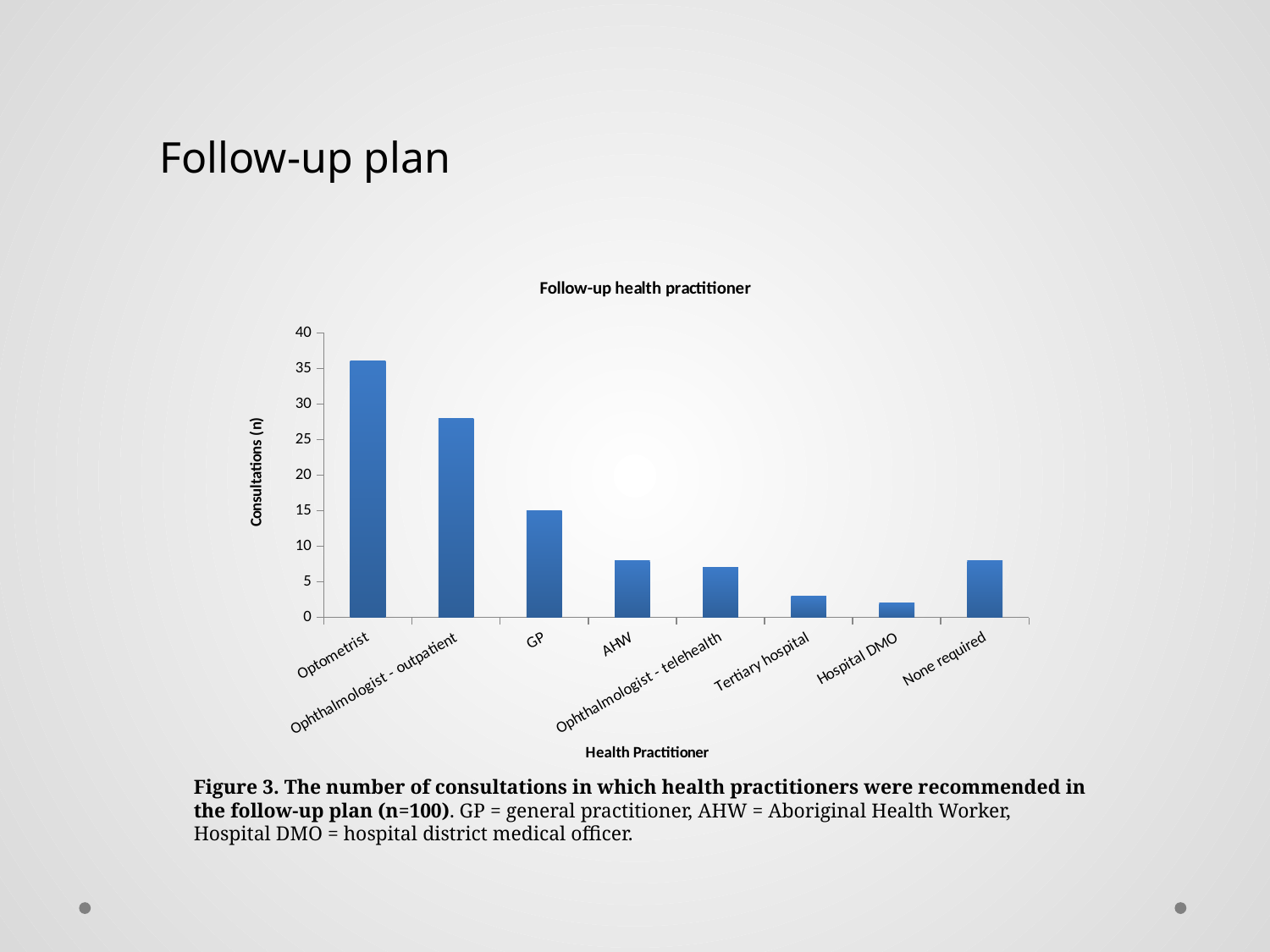
How many consultations recommended a GP in the follow-up plan? 15 How many health practitioner categories are shown on the x axis? 8 Is the value for Optometrist greater or less than 35? greater What type of chart is shown on the slide? bar chart Which health practitioner has the lowest number of consultations? Hospital DMO Which health practitioner has the highest number of consultations? Optometrist Is the value for Ophthalmologist - outpatient greater or less than 30? less Which has more consultations, Optometrist or Ophthalmologist - outpatient? Optometrist What is the label of the vertical axis? Consultations (n) What is the title of the chart? Follow-up health practitioner Do the values generally rise or fall from Optometrist to Hospital DMO along the x axis? fall Is the value for Tertiary hospital greater or less than 5? less